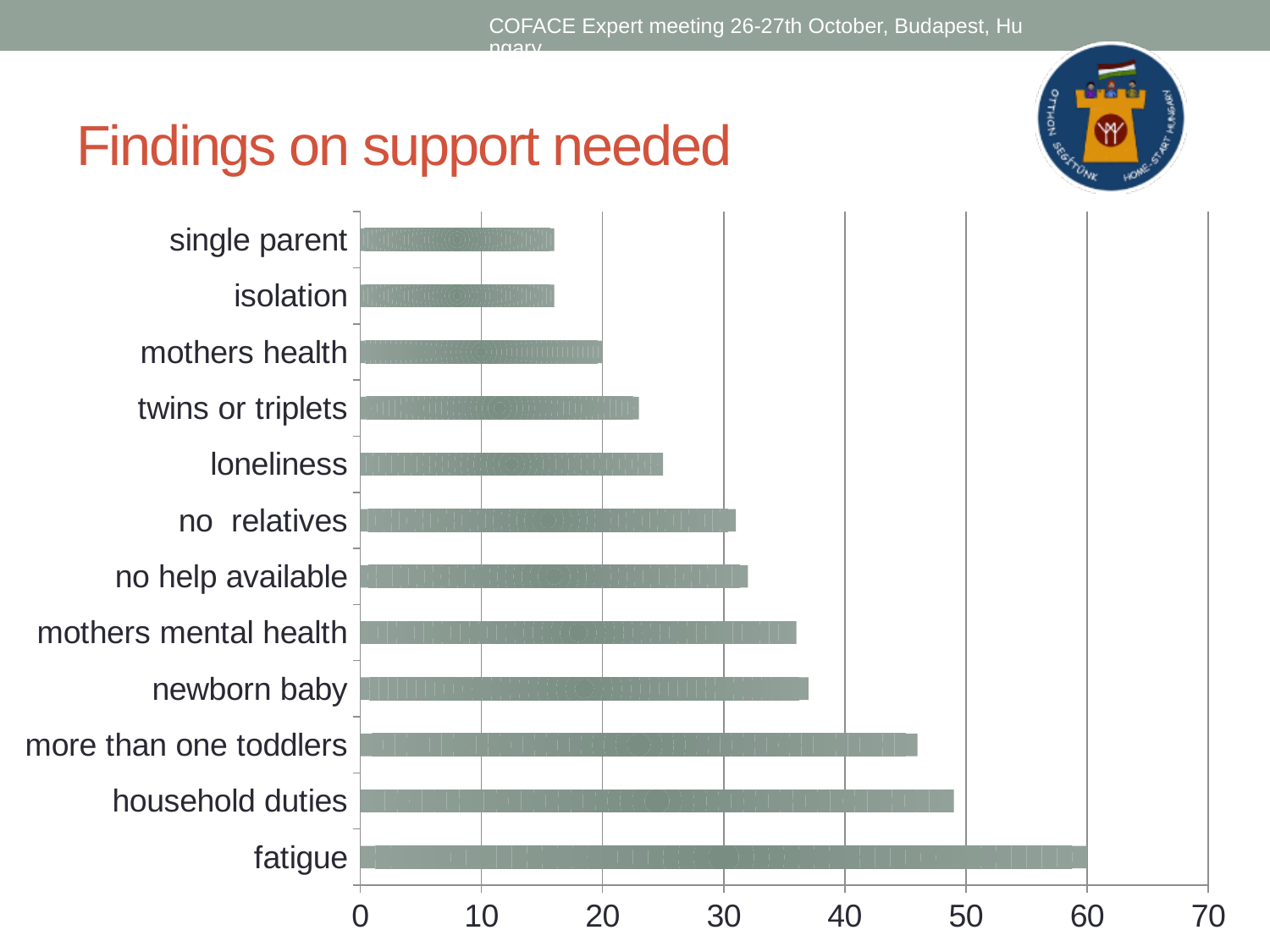
Is the value for more than one toddlers greater or less than 40? greater Which is larger, the value for twins or triplets or the value for no relatives? no relatives Which is larger, the value for household duties or the value for newborn baby? household duties What is the value for fatigue? 60 Is the value for loneliness greater or less than 20? greater Is the value for newborn baby greater or less than 40? less What is the title of the chart on the slide? Findings on support needed What type of chart is shown on the slide? bar chart What is the value for mothers health? 20 How many categories are plotted in the chart? 12 Which category has the highest value? fatigue